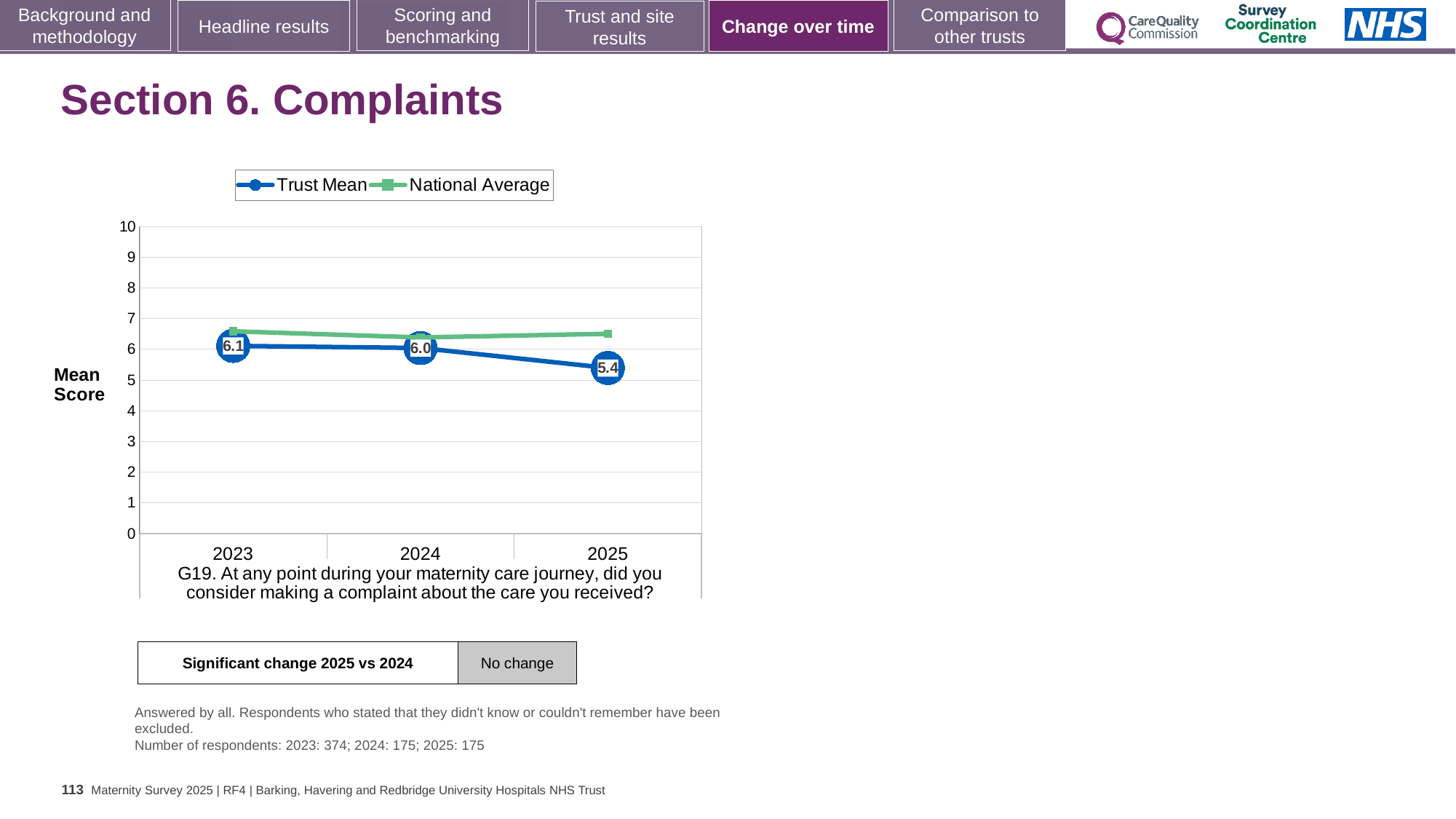
In which year is the Trust Mean score lowest? 2025 Is the National Average value for 2025 greater or less than 6? greater In which year is the Trust Mean score highest? 2023 What kind of chart is shown on the slide? line chart What is the Trust Mean score for 2025? 5.4 What is the Trust Mean score for 2024? 6.0 How many years are shown on the x axis of the chart? 3 What is the difference between the Trust Mean scores for 2023 and 2025? 0.7 Which is larger, the Trust Mean for 2024 or the Trust Mean for 2025? 2024 How many series does the chart legend list? 2 What is the Trust Mean score for 2023? 6.1 Does the Trust Mean rise or fall from 2023 to 2025? fall